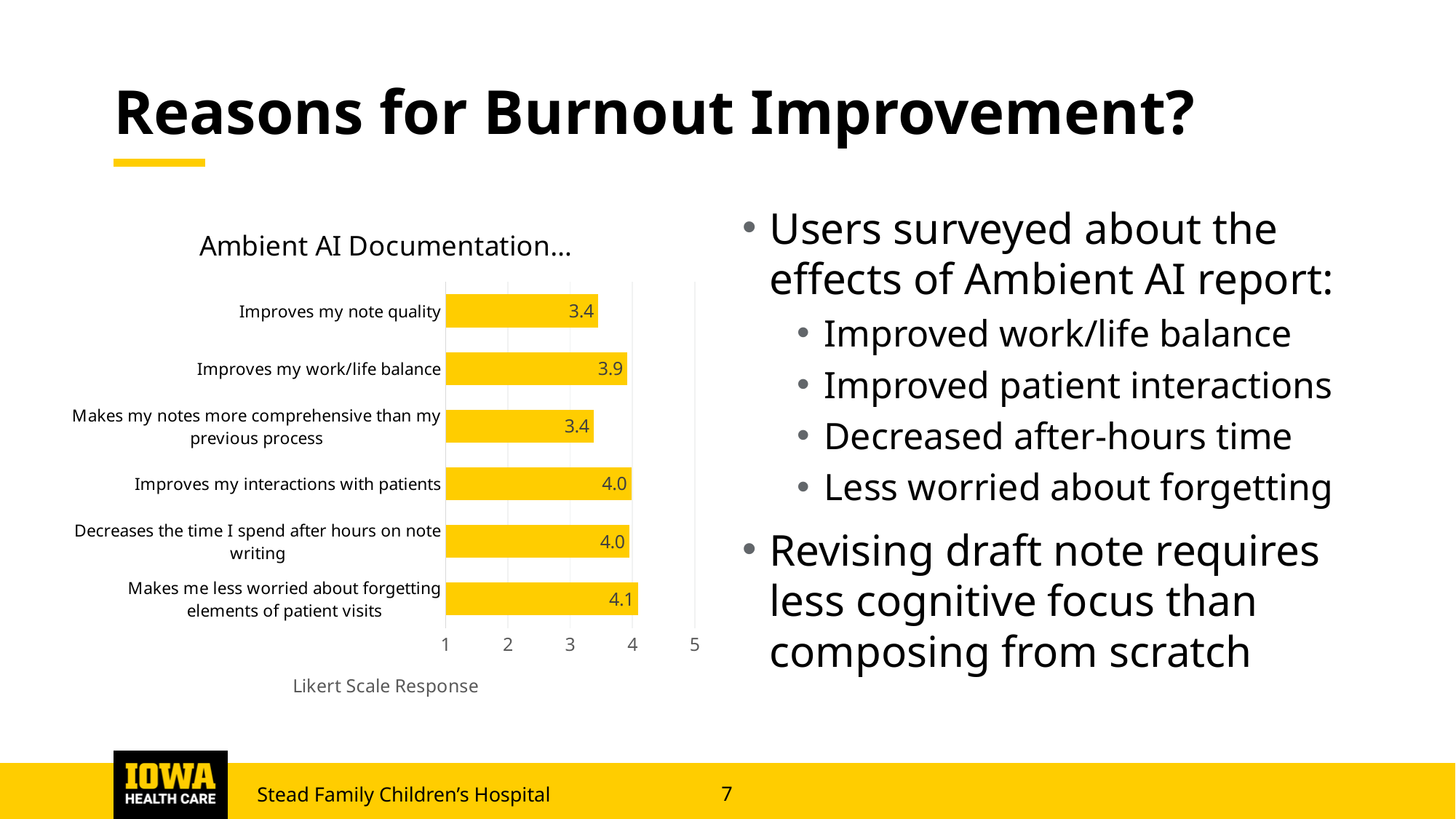
What is the value for "Makes me less worried about forgetting elements of patient visits"? 4.1 What is the value for "Improves my note quality"? 3.4 Is the value for "Improves my note quality" greater or less than 4? less Which category has the highest value? Makes me less worried about forgetting elements of patient visits What is the value for "Improves my interactions with patients"? 4.0 Which is larger: the value for "Improves my work/life balance" or the value for "Makes my notes more comprehensive than my previous process"? Improves my work/life balance What colour are the bars in the chart? yellow What kind of chart is shown on the slide? bar chart What is the value for "Improves my work/life balance"? 3.9 What is the difference between the values for "Makes me less worried about forgetting elements of patient visits" and "Improves my note quality"? 0.7 What is the label of the horizontal axis? Likert Scale Response How many categories are shown in the chart? 6